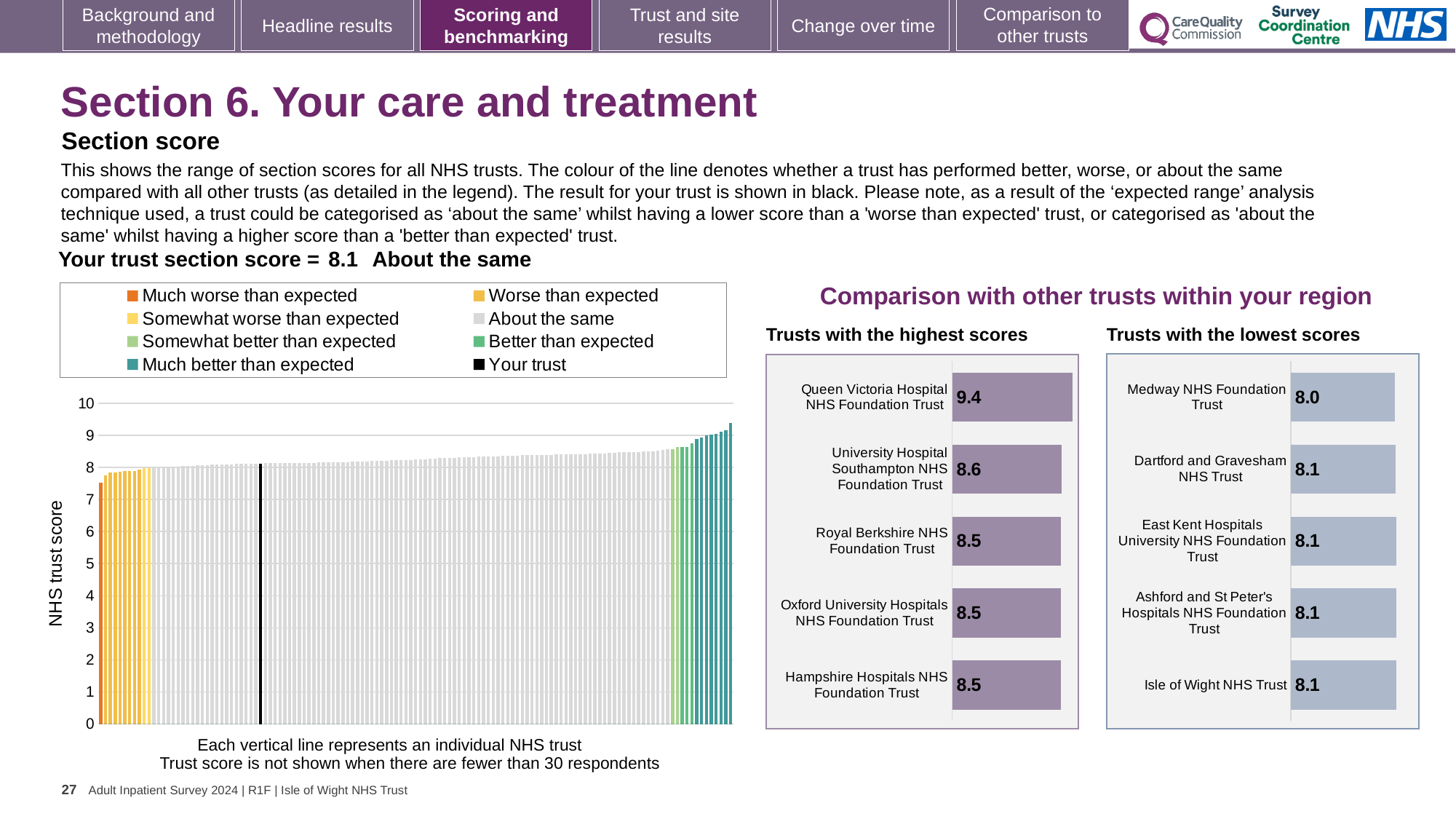
How many entries does the legend of the main 'NHS trust score' chart on the left list? 8 In the 'Trusts with the lowest scores' chart, what is the score for Isle of Wight NHS Trust? 8.1 In the main 'NHS trust score' chart on the left, do the values rise or fall from left to right along the x axis? Rise In the 'Trusts with the highest scores' chart, what is the difference between the scores of Queen Victoria Hospital NHS Foundation Trust and University Hospital Southampton NHS Foundation Trust? 0.8 Comparing the two regional charts, which has the higher score: Royal Berkshire NHS Foundation Trust or Medway NHS Foundation Trust? Royal Berkshire NHS Foundation Trust How many trusts are listed in the 'Trusts with the highest scores' chart? 5 In the 'Trusts with the lowest scores' chart, which trust has the lowest score? Medway NHS Foundation Trust In the 'Trusts with the highest scores' chart, which trust has the highest score? Queen Victoria Hospital NHS Foundation Trust What kind of chart is the main 'NHS trust score' chart on the left of the slide? Bar chart In the 'Trusts with the highest scores' chart, what is the score for Queen Victoria Hospital NHS Foundation Trust? 9.4 In the 'Trusts with the lowest scores' chart, what is the score for Medway NHS Foundation Trust? 8.0 In the main 'NHS trust score' chart on the left, what colour is used to show 'Your trust'? Black